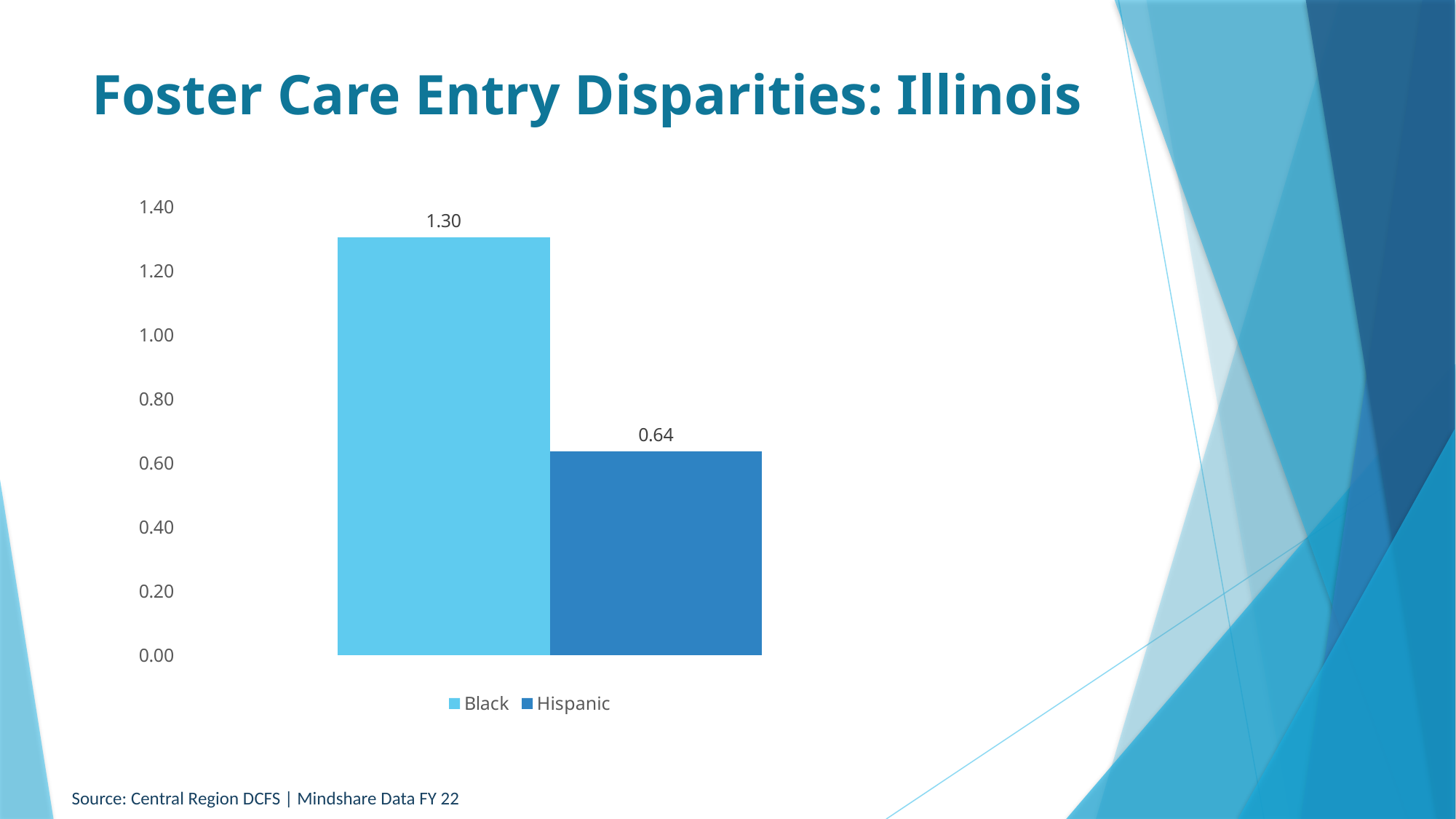
Which is larger, the value for Black or the value for Hispanic? Black Is the value for Black greater or less than 1.20? greater Which series has the highest value? Black How many series does the legend list? 2 What kind of chart is shown on the slide? bar chart What is the value for Hispanic? 0.64 Which series has the lowest value? Hispanic What is the value for Black? 1.30 Is the value for Hispanic greater or less than 0.80? less What is the difference between the values for Black and Hispanic? 0.66 What is the maximum value shown on the vertical axis? 1.40 What is the title of the slide? Foster Care Entry Disparities: Illinois